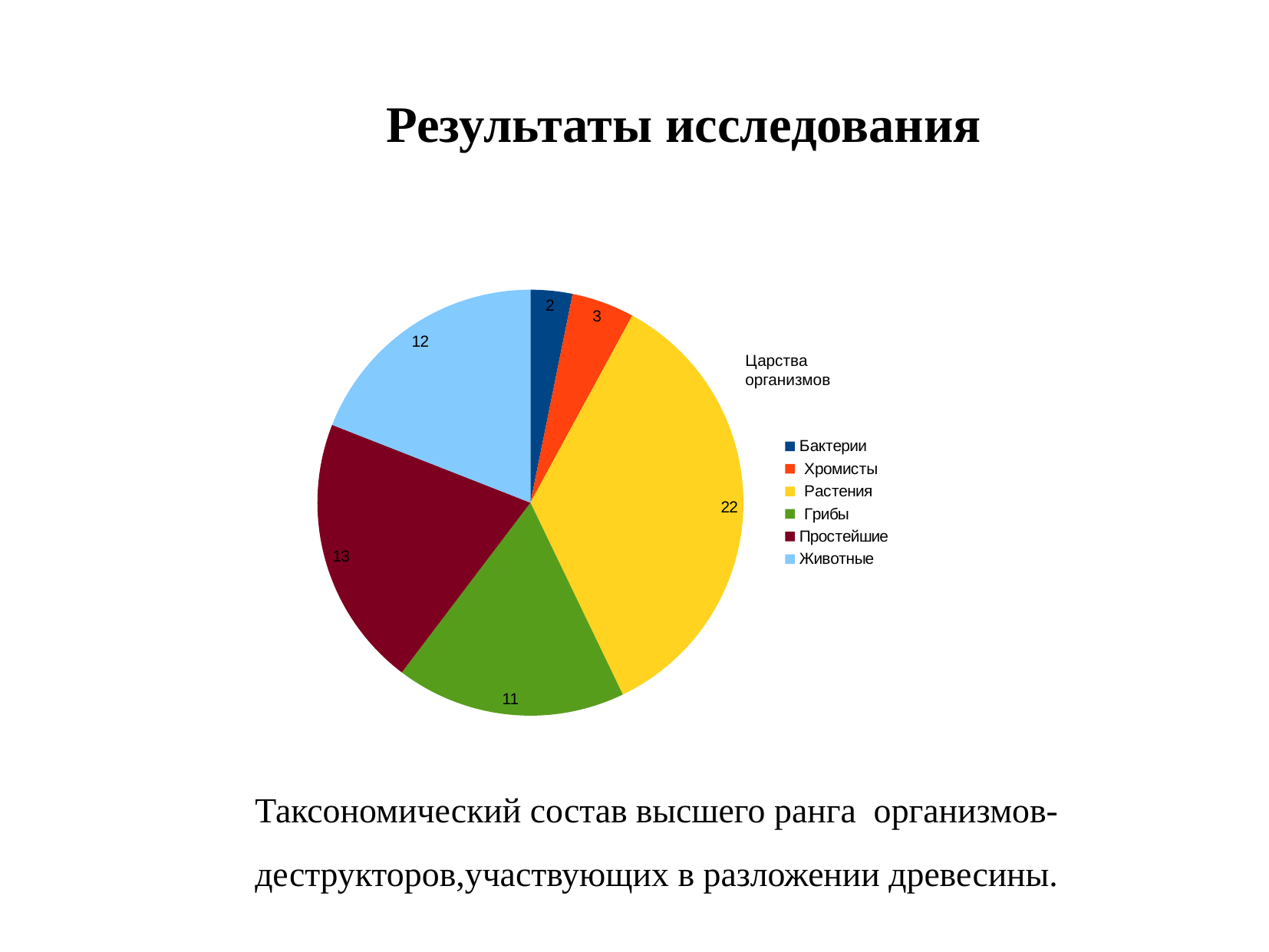
What kind of chart is shown on the slide? pie chart What is the difference between the values for Растения and Грибы? 11 What is the value for Бактерии in the pie chart? 2 Which category has the largest slice in the pie chart? Растения Which category has the smallest slice in the pie chart? Бактерии What is the value for Простейшие in the pie chart? 13 What is the total of all the values shown in the pie chart? 63 How many categories does the pie chart have? 6 What is the value for Животные in the pie chart? 12 What is the value for Растения in the pie chart? 22 Which is larger, the value for Хромисты or the value for Грибы? Грибы What is the title shown above the legend of the pie chart? Царства организмов